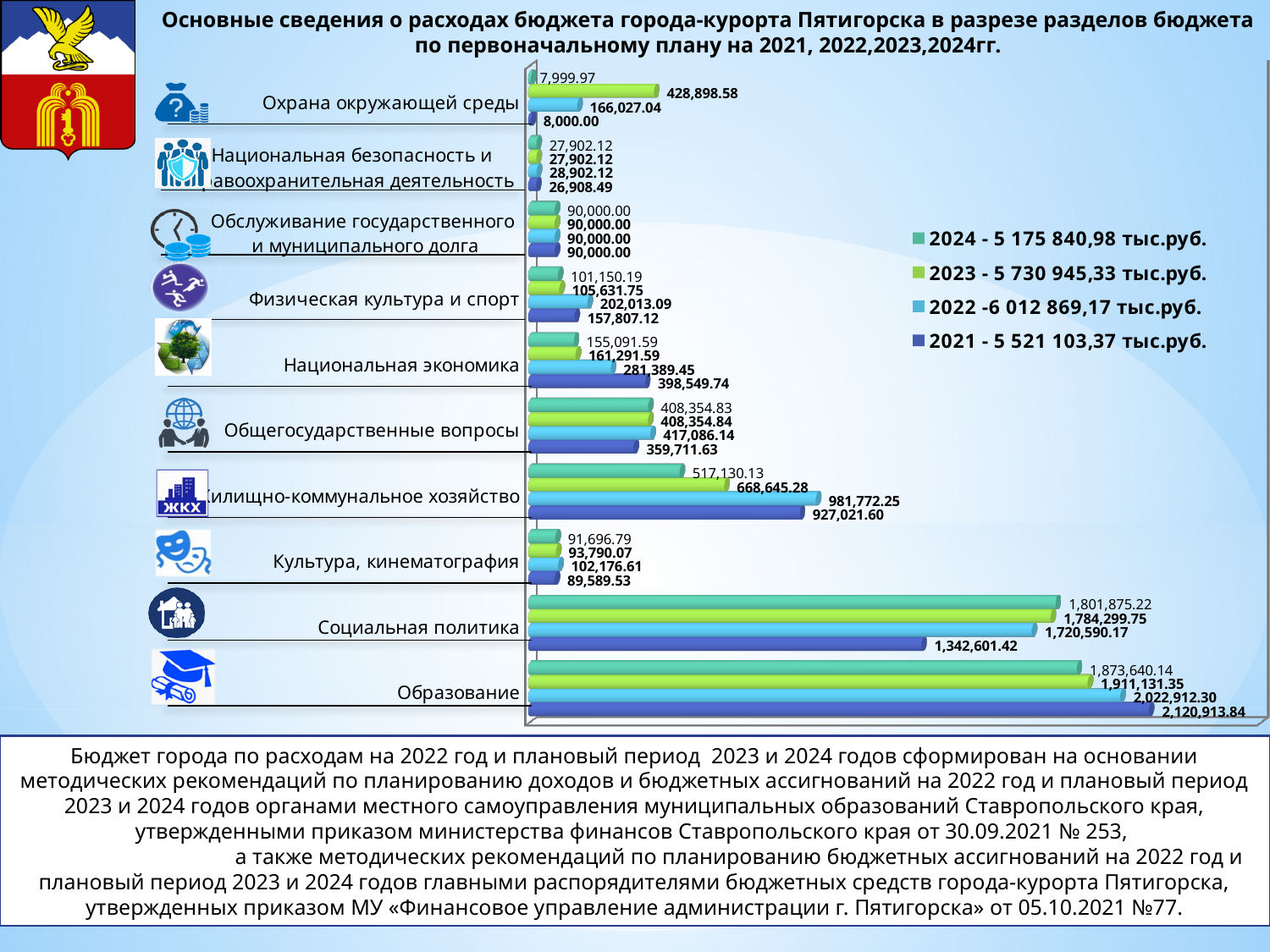
How many budget sections (categories) are shown in the chart? 10 What is the 2022 value for Образование? 2,022,912.30 What kind of chart is shown on the slide? Bar chart Which category has the highest value in the 2021 series? Образование What is the 2023 value for Охрана окружающей среды? 428,898.58 According to the legend, what is the total for 2022? 6 012 869,17 тыс.руб. For Национальная экономика, which is larger: the 2021 value or the 2022 value? 2021 Which category has the lowest value in the 2024 series? Охрана окружающей среды How many series does the legend list? 4 What is the difference between the 2022 and 2021 values for Жилищно-коммунальное хозяйство? 54,750.65 What is the 2024 value for Жилищно-коммунальное хозяйство? 517,130.13 What is the 2021 value for Социальная политика? 1,342,601.42